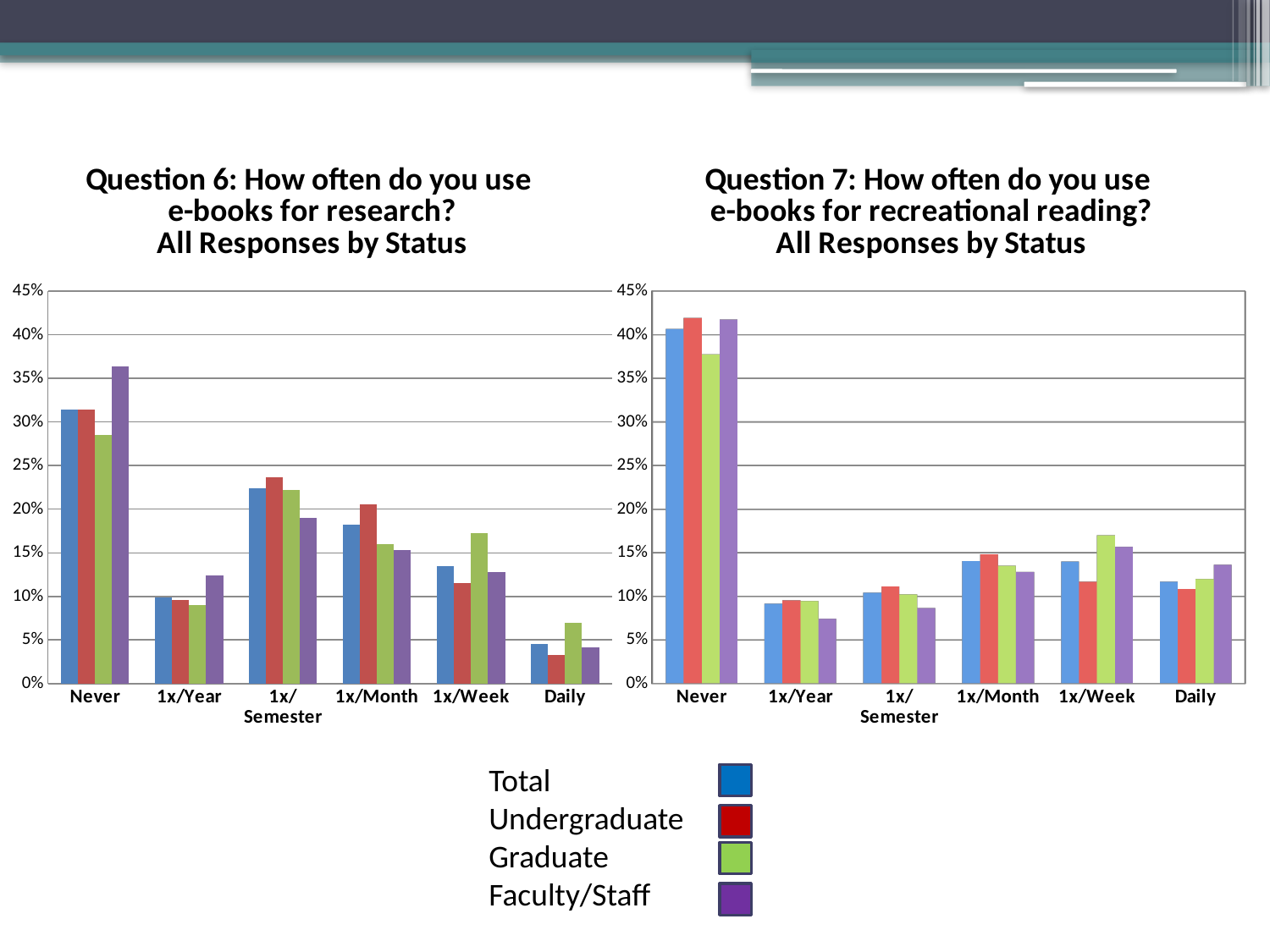
In the Question 6 chart, which category has the lowest Total value? Daily Which legend entry is shown in green? Graduate How many categories are shown on the x axis of the Question 7 chart? 6 In the Question 6 chart, is the Faculty/Staff value for Never greater or less than 35%? greater In the Question 7 chart, is the Faculty/Staff value for 1x/Year greater or less than 10%? less In the Question 7 chart, which category has the highest Total value? Never What kind of chart is the Question 6 chart on the left? bar chart How many series does the legend list for the charts? 4 In the Question 7 chart, is the Graduate value for Never greater or less than 35%? greater In the Question 6 chart, which is larger for 1x/Week: the Graduate value or the Undergraduate value? Graduate In the Question 6 chart, which category has the highest Total value? Never